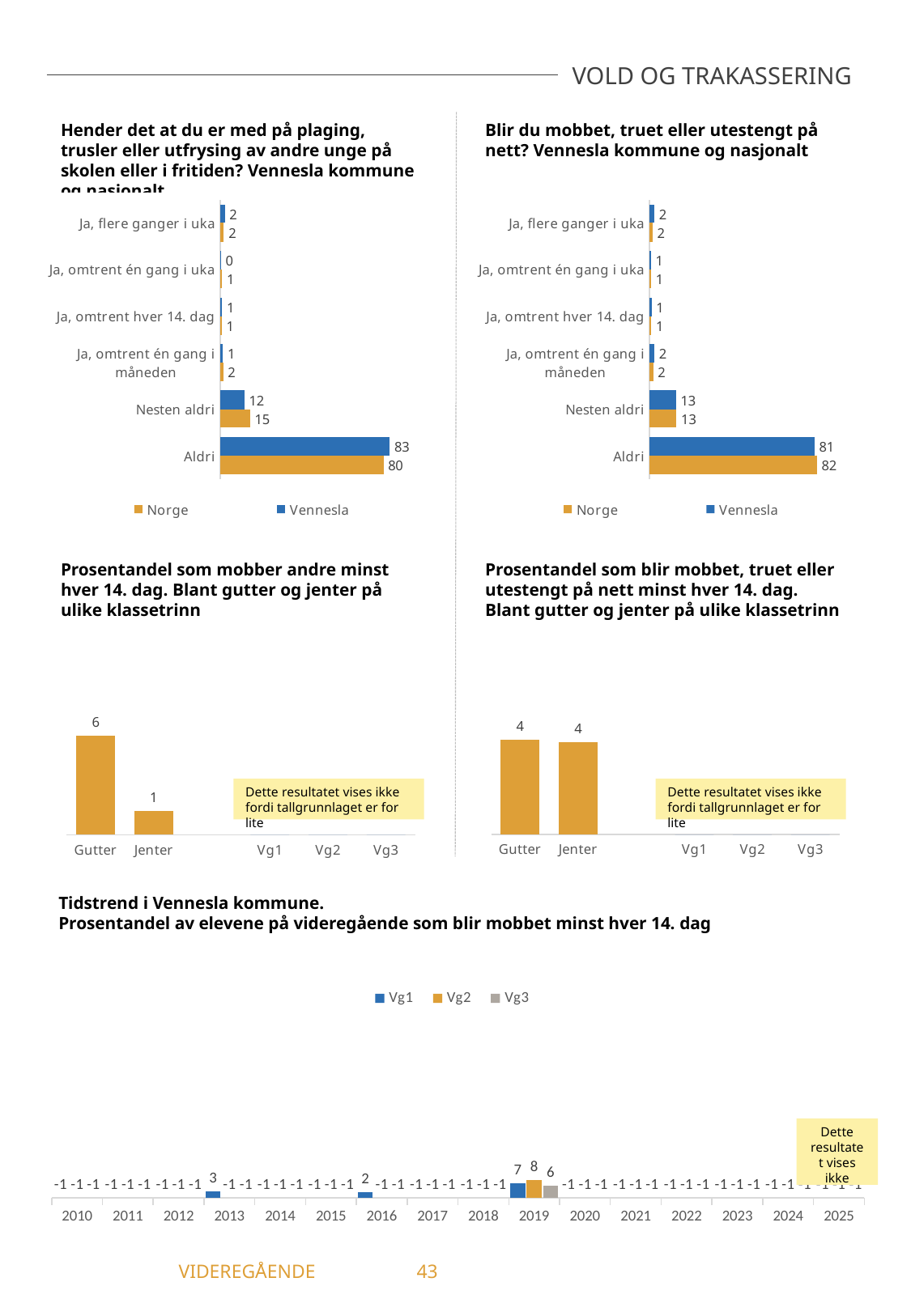
In the chart 'Hender det at du er med på plaging, trusler eller utfrysing av andre unge på skolen eller i fritiden?', what is the difference between Norge and Vennesla for 'Nesten aldri'? 3 In the chart 'Prosentandel som mobber andre minst hver 14. dag', which is larger, Gutter or Jenter? Gutter In the chart 'Prosentandel som blir mobbet, truet eller utestengt på nett minst hver 14. dag', what is the value for Jenter? 4 In the chart 'Tidstrend i Vennesla kommune', what is the value for Vg2 in 2019? 8 In the chart 'Hender det at du er med på plaging, trusler eller utfrysing av andre unge på skolen eller i fritiden?', what is the value for Norge in the 'Nesten aldri' category? 15 In the chart 'Hender det at du er med på plaging, trusler eller utfrysing av andre unge på skolen eller i fritiden?', what is the value for Vennesla in the 'Aldri' category? 83 In the chart 'Prosentandel som mobber andre minst hver 14. dag', what is the value for Gutter? 6 How many series does the legend list in the chart 'Blir du mobbet, truet eller utestengt på nett?'? 2 In the chart 'Blir du mobbet, truet eller utestengt på nett?', what is the value for Norge in the 'Aldri' category? 82 What kind of chart is 'Hender det at du er med på plaging, trusler eller utfrysing av andre unge på skolen eller i fritiden?'? Bar chart How many series does the legend list in the chart 'Tidstrend i Vennesla kommune'? 3 In the chart 'Blir du mobbet, truet eller utestengt på nett?', which category has the highest value for Vennesla? Aldri